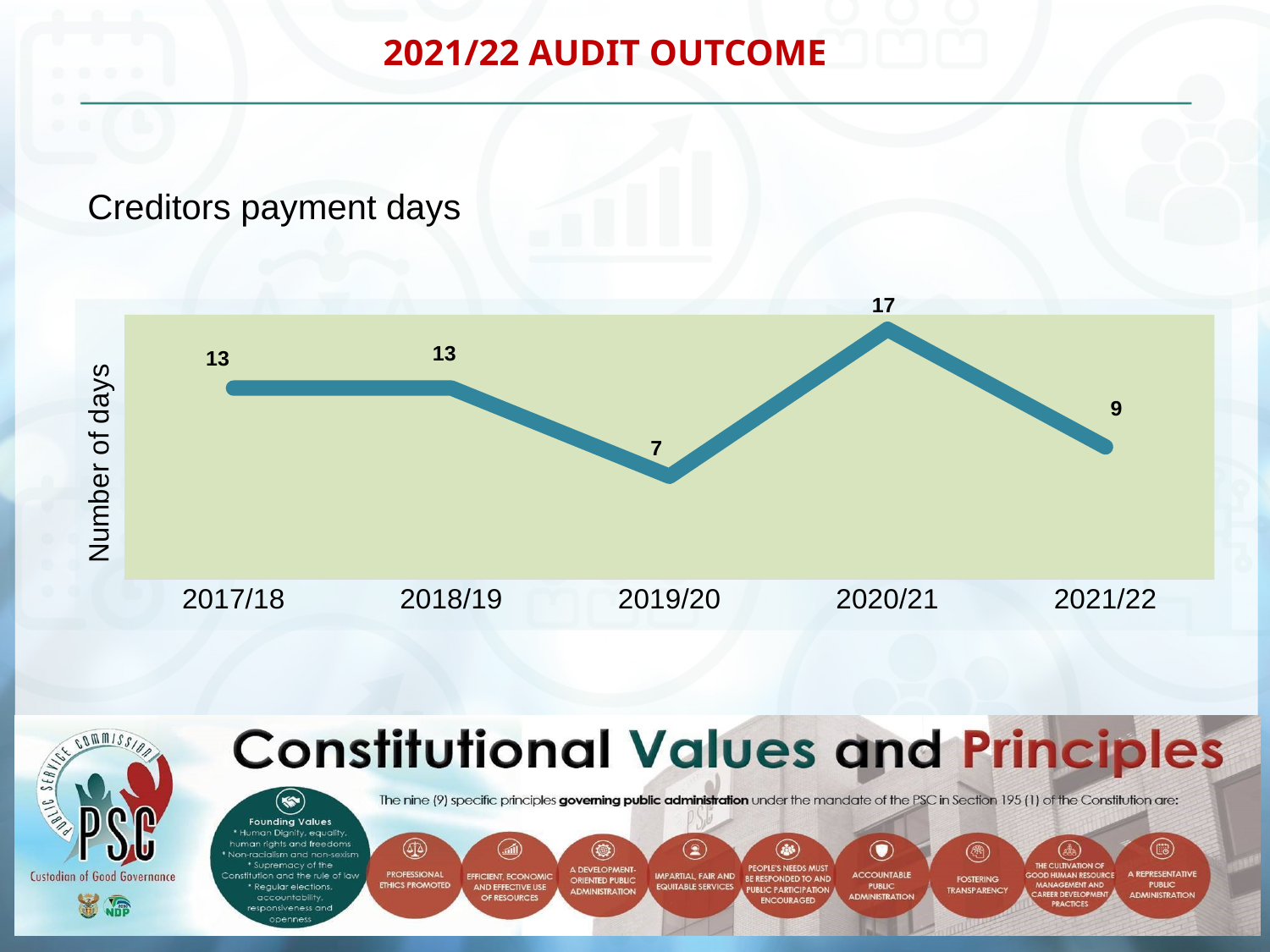
What is the number of creditors payment days for 2017/18? 13 What is the difference in creditors payment days between 2020/21 and 2021/22? 8 Which year has more creditors payment days, 2018/19 or 2019/20? 2018/19 What is the label on the vertical axis of the chart? Number of days Did the number of creditors payment days rise or fall from 2020/21 to 2021/22? Fall What is the number of creditors payment days for 2019/20? 7 Which year has the lowest number of creditors payment days? 2019/20 What is the number of creditors payment days for 2021/22? 9 How many financial years are plotted on the chart? 5 What is the number of creditors payment days for 2020/21? 17 Which year has the highest number of creditors payment days? 2020/21 What type of chart is used to show creditors payment days? Line chart